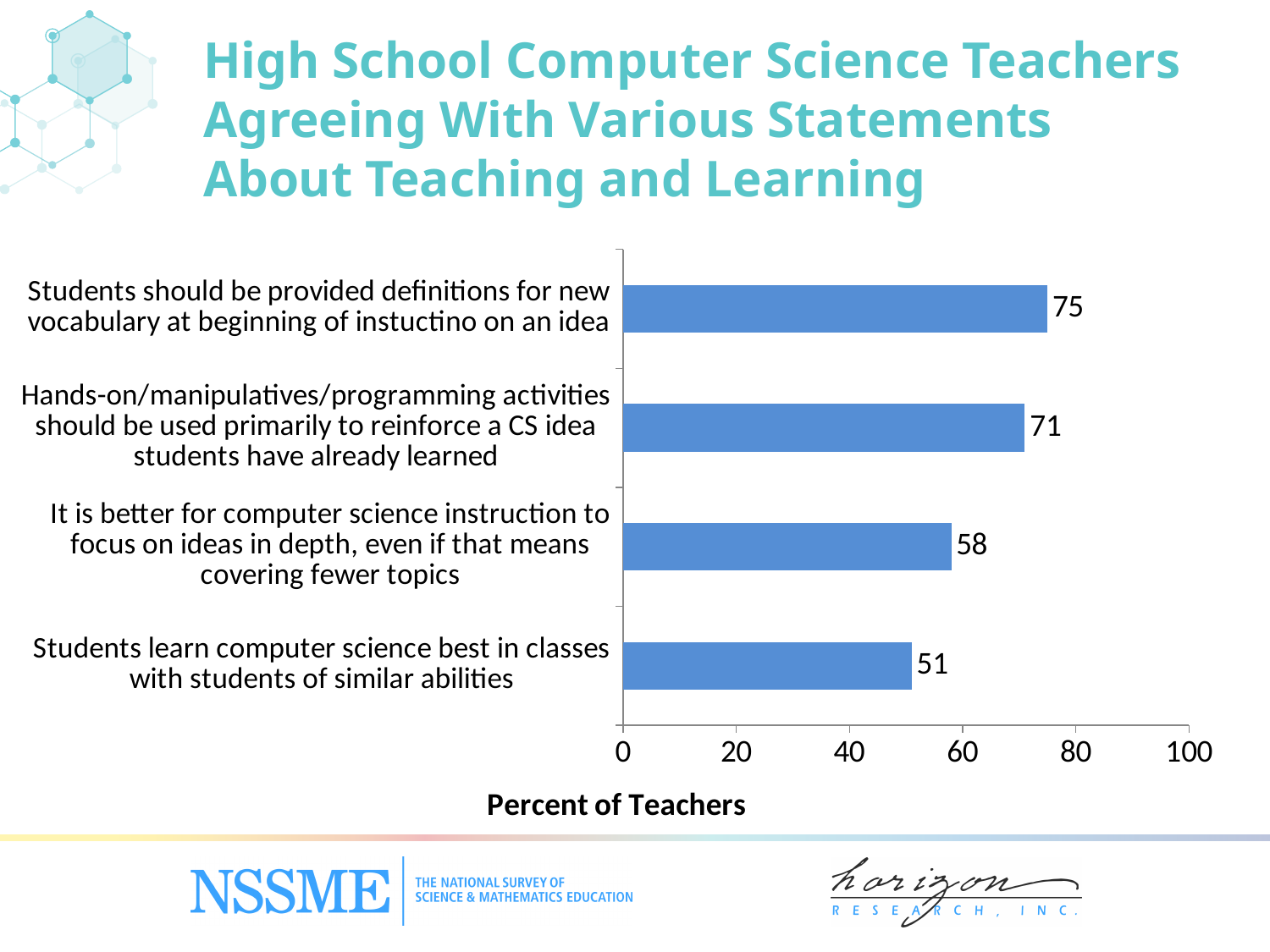
What kind of chart is shown on the slide? Bar chart What percent of teachers agree that hands-on/manipulatives/programming activities should be used primarily to reinforce a CS idea students have already learned? 71 Which statement has the highest percent of teachers agreeing? Students should be provided definitions for new vocabulary at beginning of instruction on an idea Which statement has the lowest percent of teachers agreeing? Students learn computer science best in classes with students of similar abilities What is the difference in percent of teachers between the statement about providing definitions for new vocabulary and the statement about students learning best in classes with students of similar abilities? 24 Is the value for the statement about focusing on ideas in depth greater or less than 60? less What percent of teachers agree that students should be provided definitions for new vocabulary at the beginning of instruction on an idea? 75 How many statements are shown in the chart? 4 What percent of teachers agree that it is better for computer science instruction to focus on ideas in depth, even if that means covering fewer topics? 58 Which has a higher percent of teachers agreeing: the statement about hands-on activities reinforcing a CS idea already learned, or the statement about focusing on ideas in depth? Hands-on/manipulatives/programming activities should be used primarily to reinforce a CS idea students have already learned What percent of teachers agree that students learn computer science best in classes with students of similar abilities? 51 What is the label on the horizontal axis of the chart? Percent of Teachers